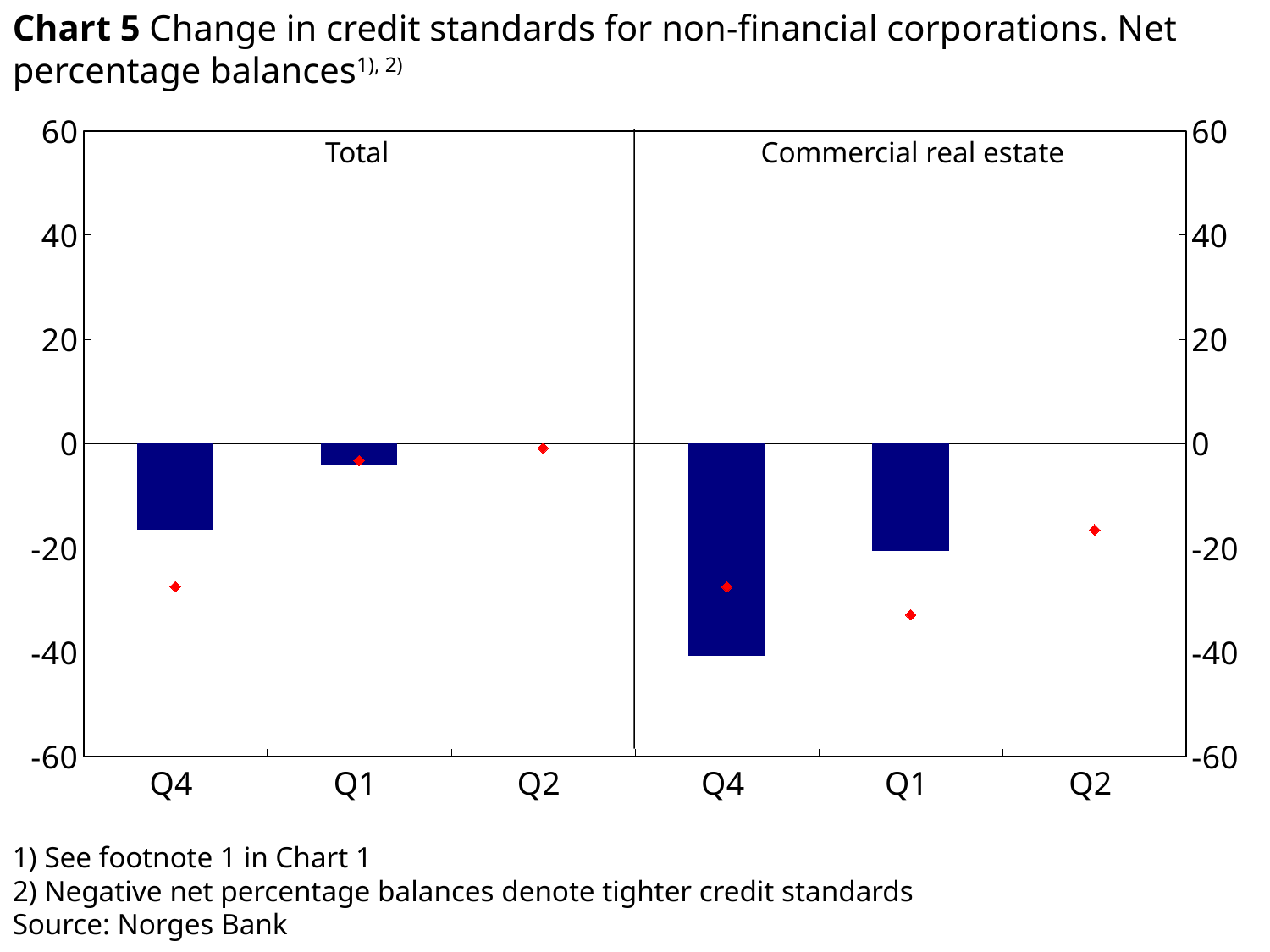
Is the bar for Q1 in the Commercial real estate panel greater or less than -40? greater In the Total panel, do the bars rise or fall from Q4 to Q2? rise What are the two panels of the chart labelled? Total and Commercial real estate What kind of chart is shown on the slide? combination chart (bars with red diamond markers) Is the bar for Q4 in the Commercial real estate panel greater or less than -20? less Which bar is lower, Q4 in the Total panel or Q4 in the Commercial real estate panel? Q4 in Commercial real estate Which bar is the lowest (most negative) in the chart? Q4 in Commercial real estate What is the title of the chart? Chart 5 Change in credit standards for non-financial corporations. Net percentage balances Is the bar for Q1 in the Total panel greater or less than -20? greater How many quarter categories are shown across both panels of the chart? 6